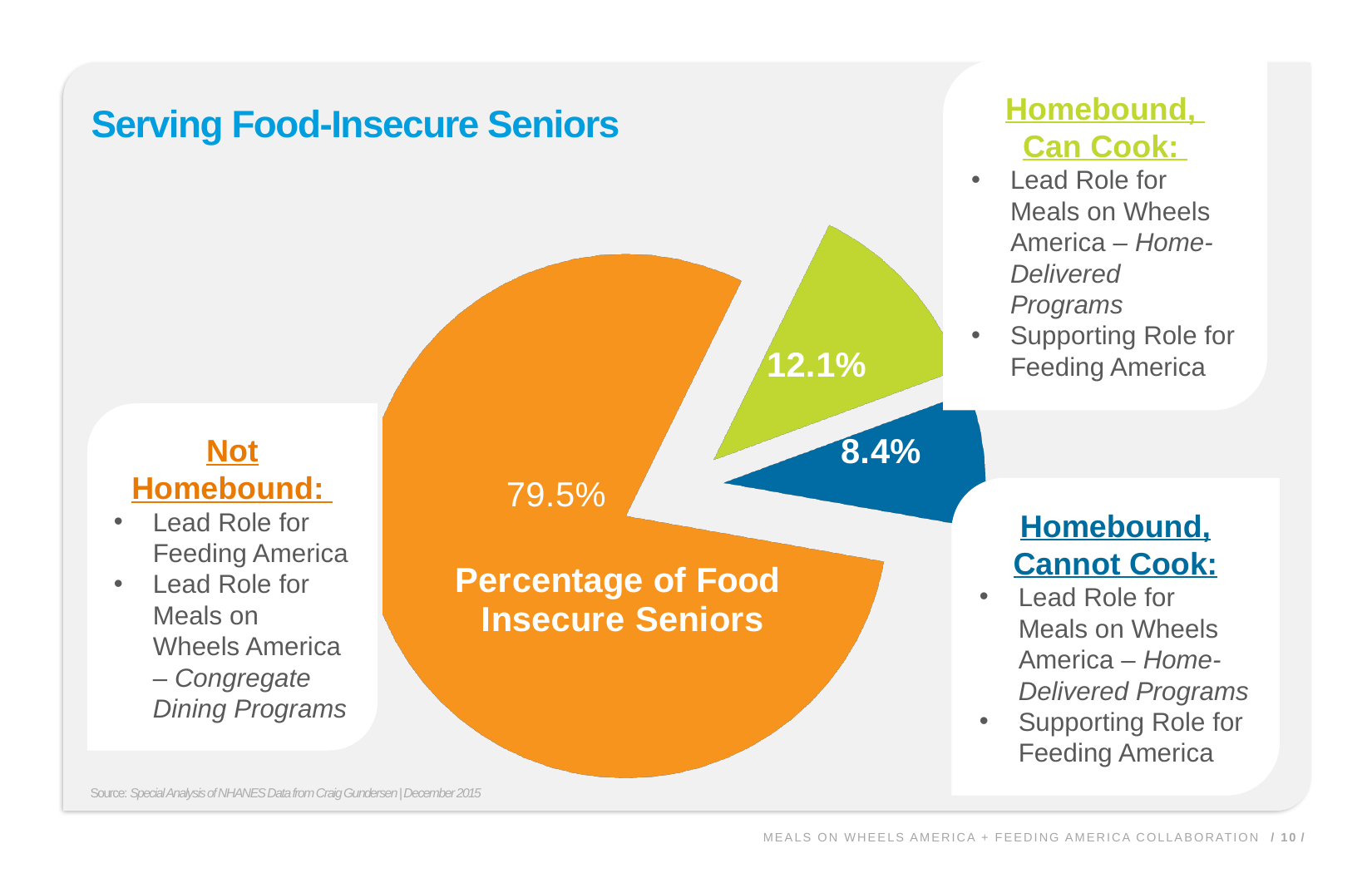
What percentage of food-insecure seniors are Homebound, Can Cook? 12.1% What type of chart is shown on the slide? pie chart What is the difference in percentage points between the Homebound, Can Cook slice and the Homebound, Cannot Cook slice? 3.7 What percentage of food-insecure seniors are Homebound, Cannot Cook? 8.4% What colour is the slice representing Homebound, Cannot Cook seniors? blue How many slices does the pie chart have? 3 Which group has the smallest share of the pie? Homebound, Cannot Cook Which group has the largest share of the pie? Not Homebound What percentage of food-insecure seniors are Not Homebound? 79.5% What is the difference in percentage points between the Not Homebound slice and the Homebound, Can Cook slice? 67.4 What is the label printed in the centre of the pie chart? Percentage of Food Insecure Seniors Which is larger: the Homebound, Can Cook slice or the Homebound, Cannot Cook slice? Homebound, Can Cook